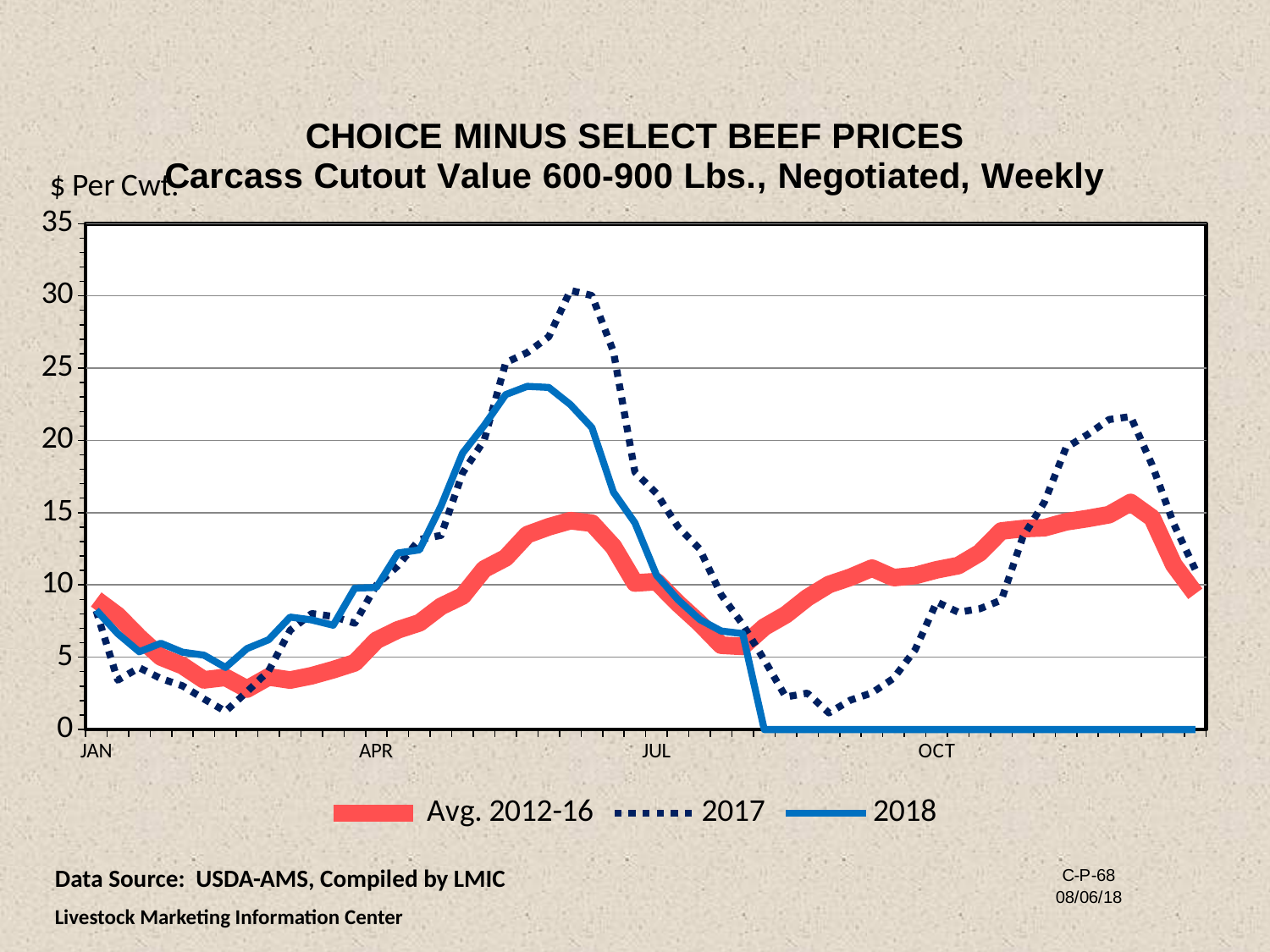
How many series does the legend list? 3 Is the peak value of the 2017 series greater or less than 25? greater In early October, which series is higher: Avg. 2012-16 or 2017? Avg. 2012-16 Is the value of the 2018 series at the start of January greater or less than 5? greater What is the label on the y axis? $ Per Cwt. At their June peaks, which series is higher: 2017 or 2018? 2017 Is the peak value of the 2018 series greater or less than 20? greater Which series reaches the highest value on the chart? 2017 What kind of chart is shown on the slide? line chart Does the Avg. 2012-16 series rise or fall from JUL to mid-August? fall What is the data source given below the chart? USDA-AMS, Compiled by LMIC